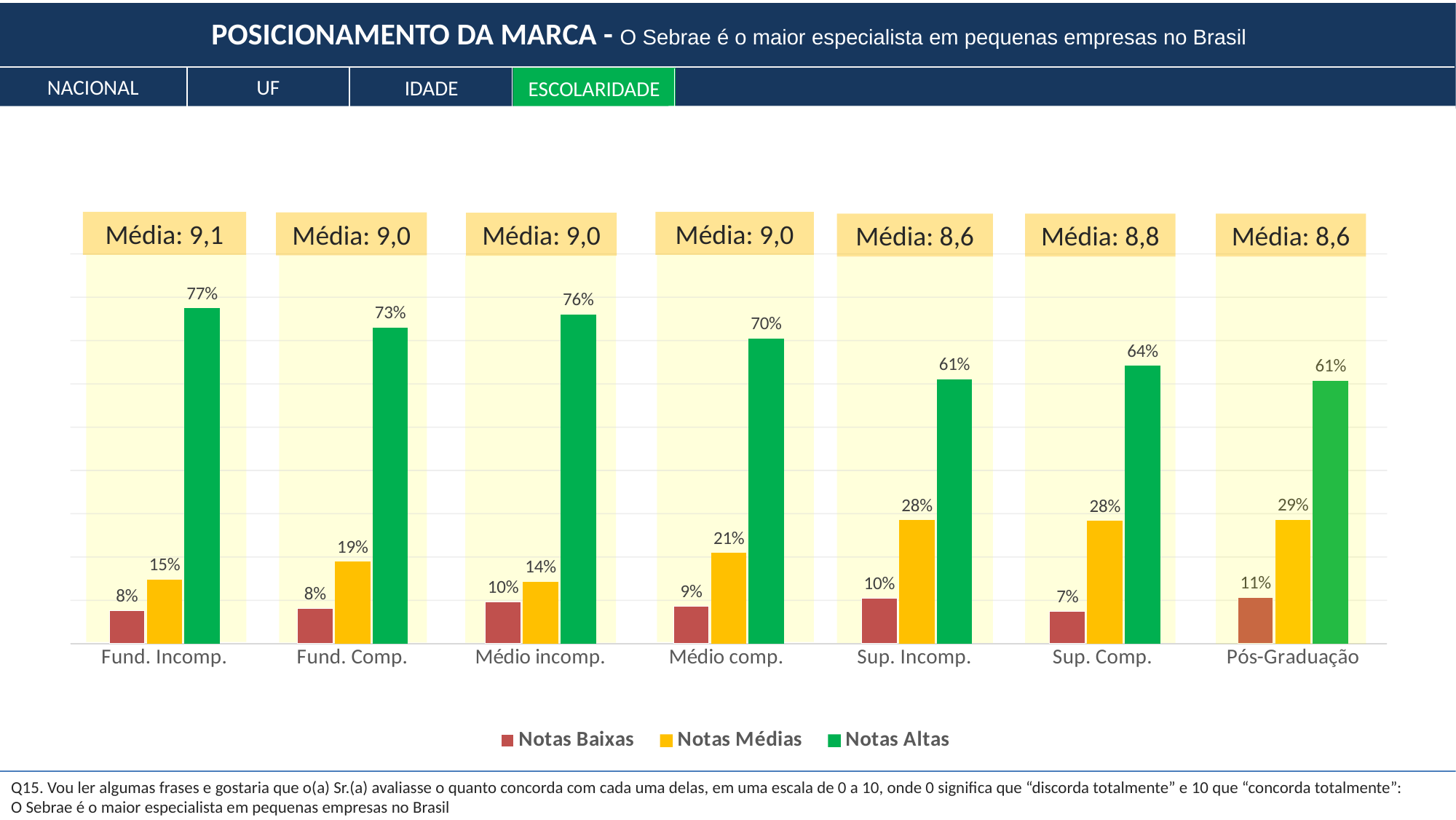
What is the Média shown above the Sup. Comp. category? 8,8 What is the value of Notas Altas for Fund. Incomp.? 77% What is the value of Notas Baixas for Sup. Comp.? 7% What kind of chart is shown on the slide? Bar chart How many series does the legend list? 3 What is the value of Notas Médias for Pós-Graduação? 29% Which colour represents Notas Altas in the legend? Green What is the difference between the Notas Altas values for Médio incomp. and Médio comp.? 6% How many education categories are shown on the x axis? 7 Which category has the lowest Notas Baixas value? Sup. Comp. Which category has the highest Notas Altas value? Fund. Incomp. Which is larger: Notas Médias for Sup. Incomp. or Notas Médias for Fund. Comp.? Sup. Incomp.